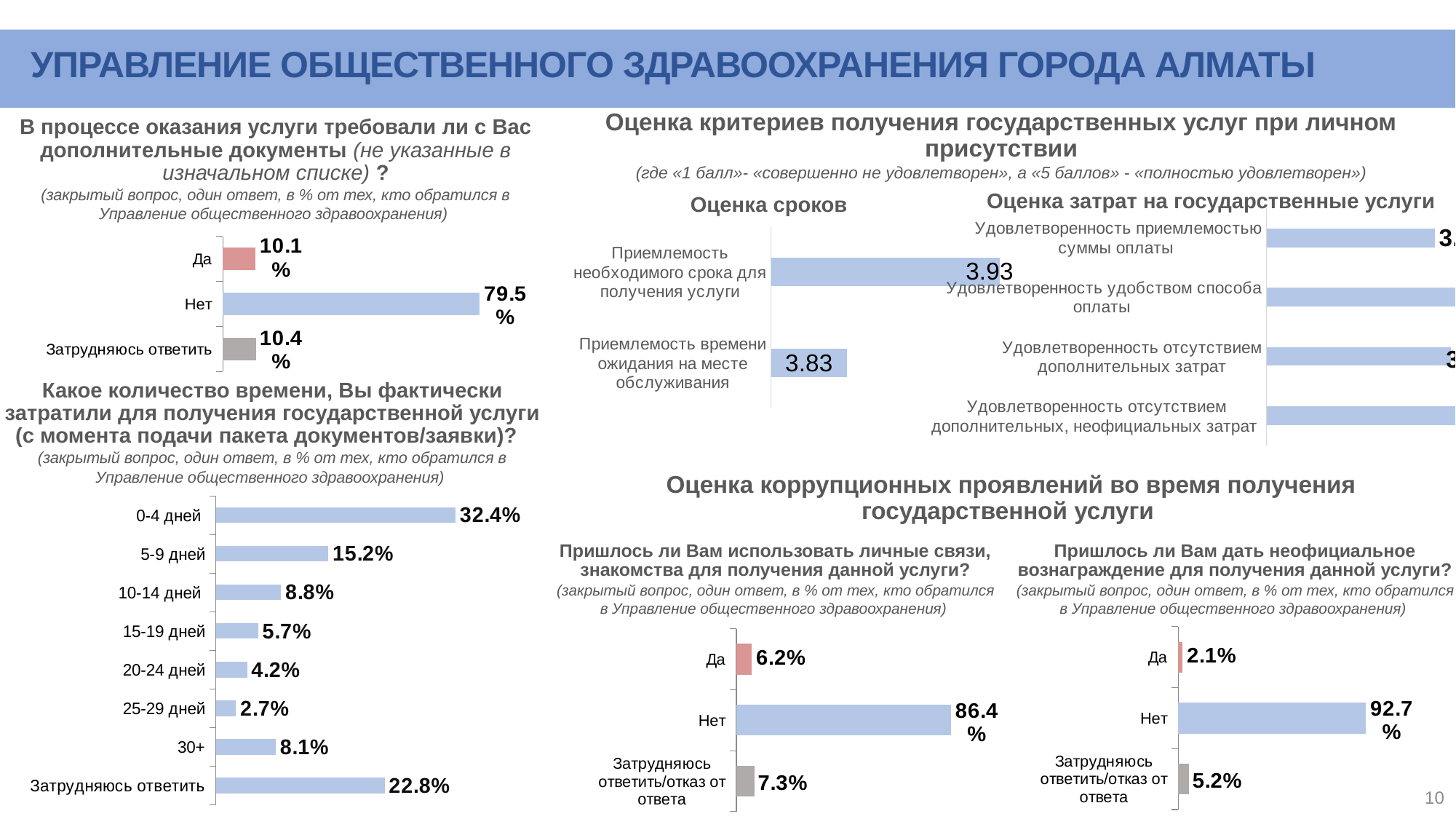
In the chart 'Какое количество времени, Вы фактически затратили для получения государственной услуги', which category has the highest value? 0-4 дней In the chart 'Пришлось ли Вам использовать личные связи, знакомства для получения данной услуги?', what is the value for 'Да'? 6.2% In the chart 'Пришлось ли Вам дать неофициальное вознаграждение для получения данной услуги?', what is the value for 'Нет'? 92.7% In the chart 'Оценка сроков', which is larger: 'Приемлемость необходимого срока для получения услуги' or 'Приемлемость времени ожидания на месте обслуживания'? Приемлемость необходимого срока для получения услуги In the chart 'Какое количество времени, Вы фактически затратили для получения государственной услуги', how many categories are shown? 8 In the chart 'Какое количество времени, Вы фактически затратили для получения государственной услуги', what is the value for '5-9 дней'? 15.2% In the chart 'Оценка сроков', what is the value for 'Приемлемость времени ожидания на месте обслуживания'? 3.83 In the chart 'Какое количество времени, Вы фактически затратили для получения государственной услуги', what is the difference between '0-4 дней' and 'Затрудняюсь ответить'? 9.6% In the chart 'В процессе оказания услуги требовали ли с Вас дополнительные документы', what is the value for 'Нет'? 79.5% In the chart 'В процессе оказания услуги требовали ли с Вас дополнительные документы', which category has the lowest value? Да In the chart 'Пришлось ли Вам дать неофициальное вознаграждение для получения данной услуги?', what is the difference between 'Затрудняюсь ответить/отказ от ответа' and 'Да'? 3.1% What type of chart is 'Какое количество времени, Вы фактически затратили для получения государственной услуги'? Bar chart